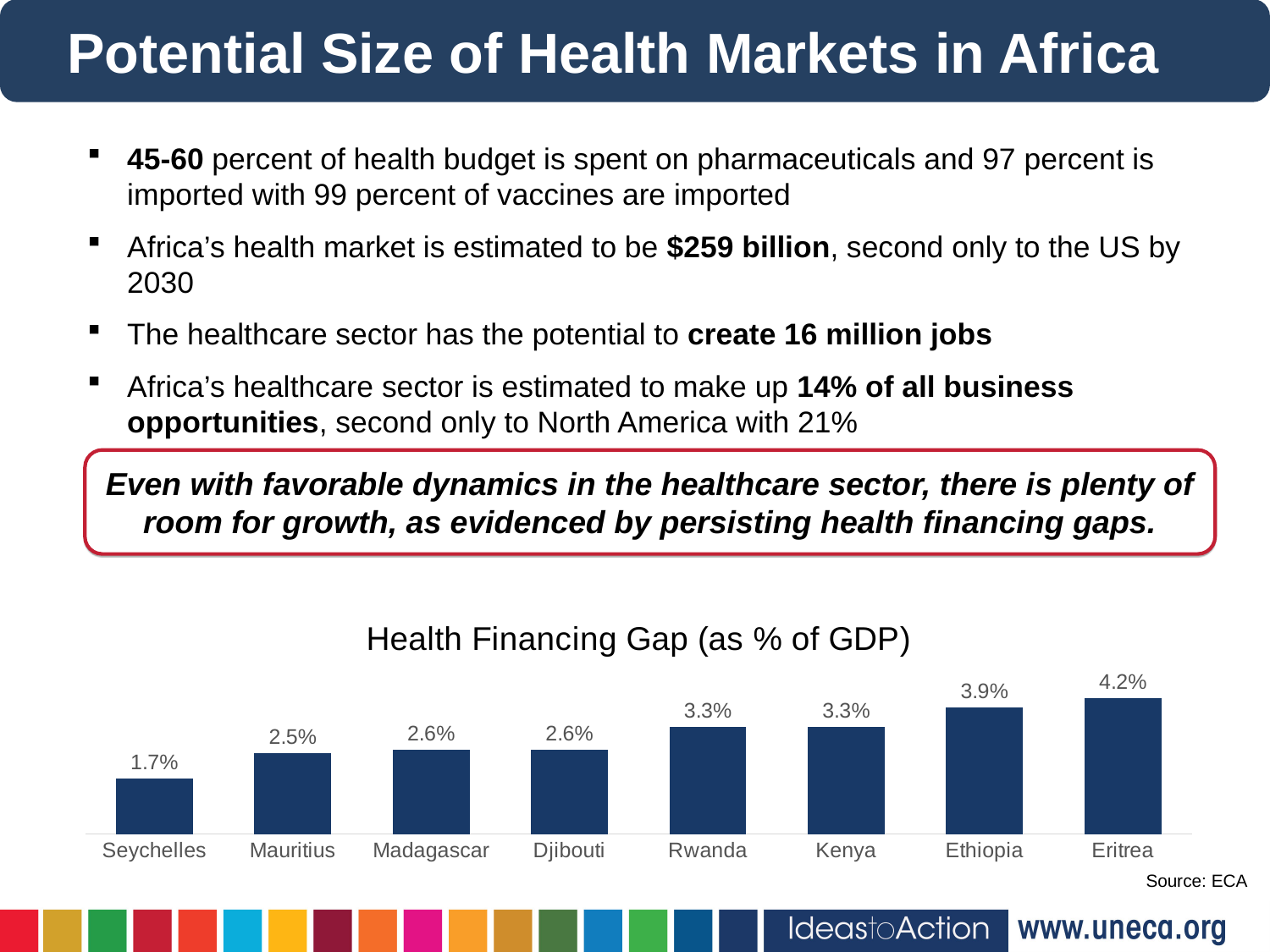
What is the difference between the health financing gap of Ethiopia and Mauritius? 1.4% What type of chart is used to show the health financing gap? Bar chart What is the difference between the health financing gap of Eritrea and Seychelles? 2.5% What is the health financing gap for Seychelles? 1.7% Which country has the highest health financing gap? Eritrea Do the values generally rise or fall from left to right across the chart? Rise Which country has the lowest health financing gap? Seychelles What is the health financing gap for Ethiopia? 3.9% What is the title of the chart? Health Financing Gap (as % of GDP) Which has a larger health financing gap, Mauritius or Kenya? Kenya How many countries are shown in the chart? 8 What is the health financing gap for Rwanda? 3.3%